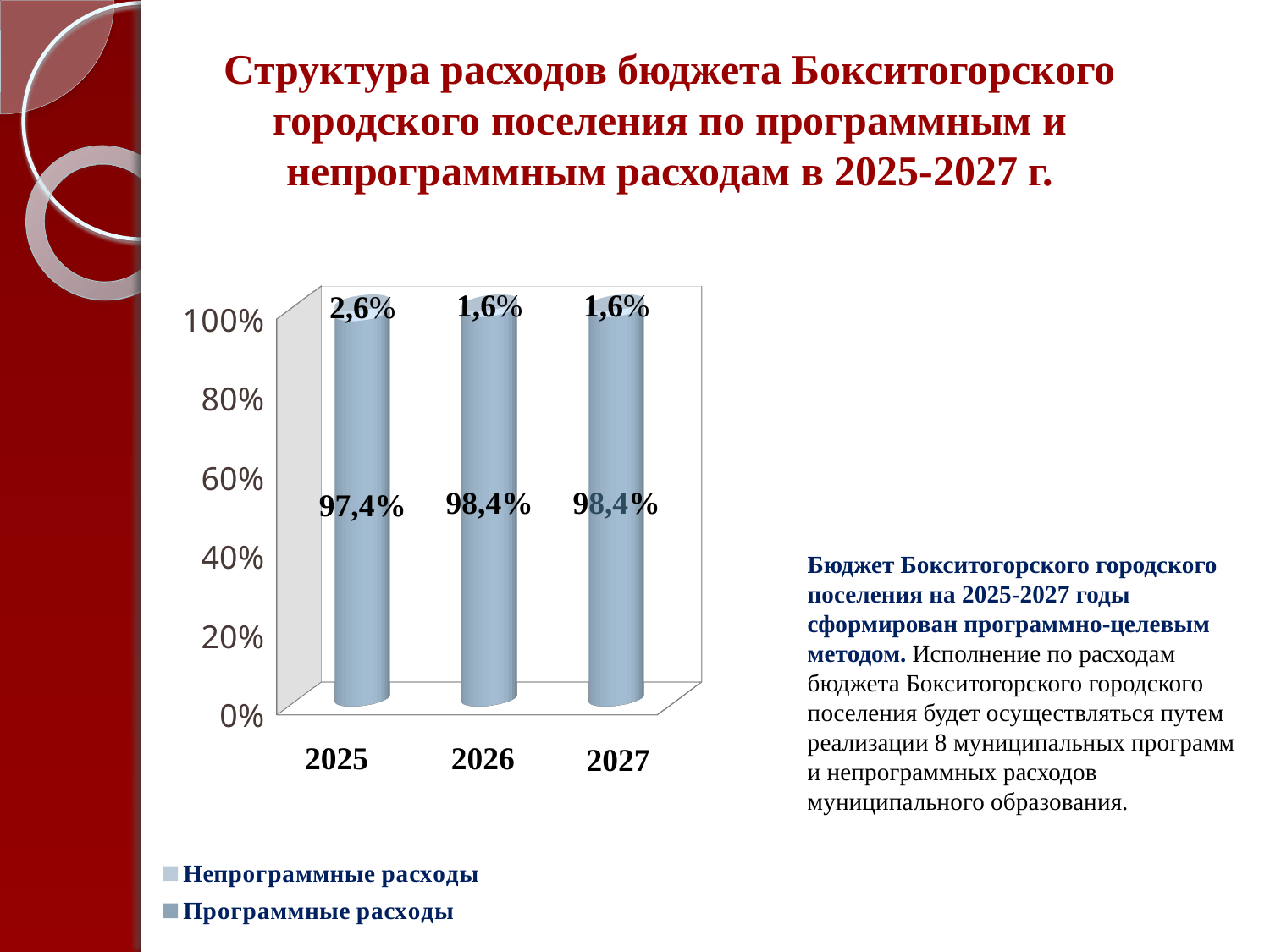
What is the share of Программные расходы in 2027? 98,4% How many years are shown on the x axis of the chart? 3 In which year is the share of Непрограммные расходы highest? 2025 In which year is the share of Программные расходы lowest? 2025 What is the share of Программные расходы in 2025? 97,4% What is the share of Непрограммные расходы in 2026? 1,6% What kind of chart is shown on the slide? Stacked bar chart How many series does the legend list? 2 What is the difference between the share of Программные расходы in 2026 and in 2025? 1,0% Does the share of Непрограммные расходы rise or fall from 2025 to 2026? Fall What is the share of Непрограммные расходы in 2025? 2,6% Which is larger: the share of Непрограммные расходы in 2025 or in 2027? 2025